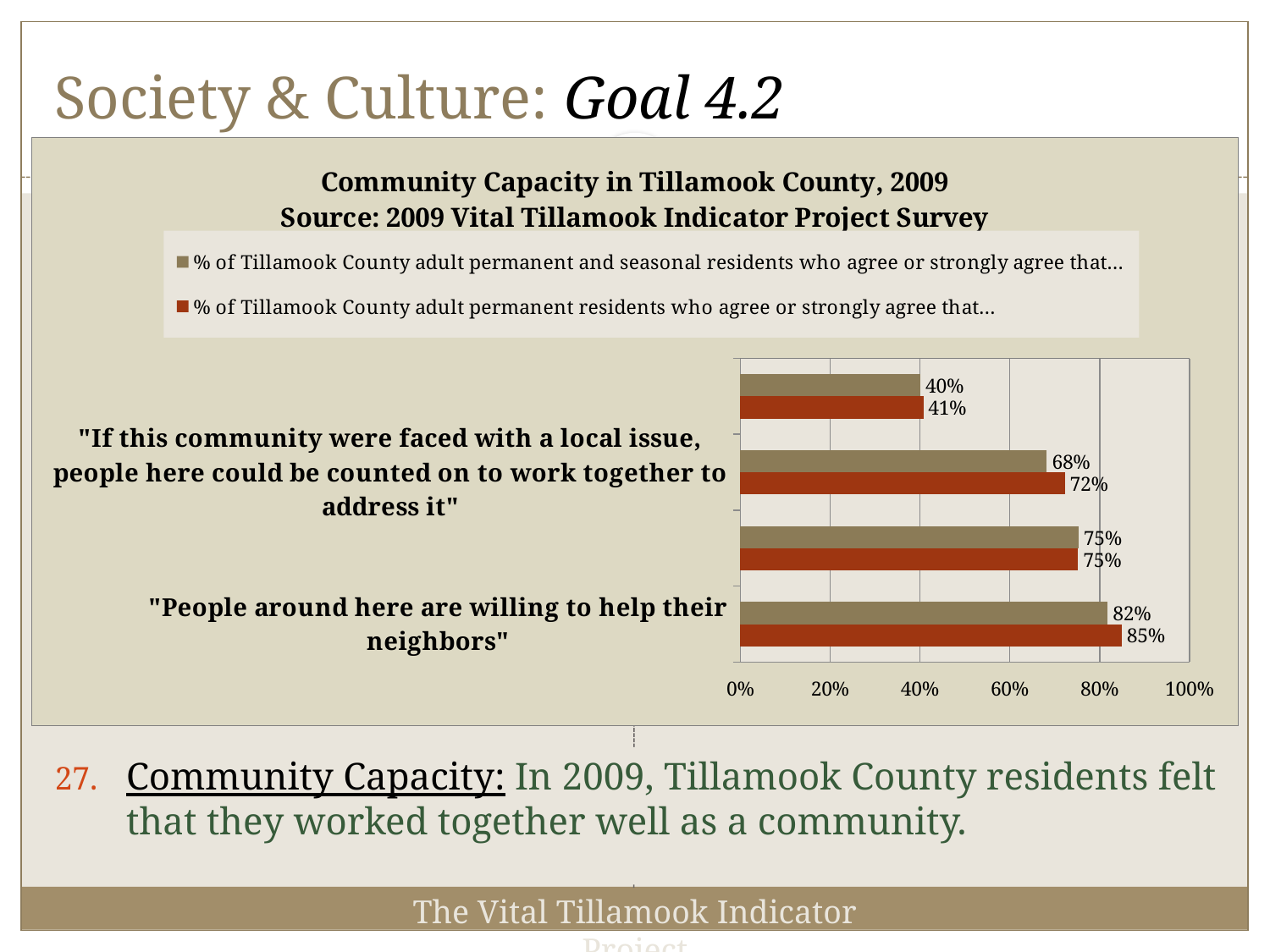
For "People around here are willing to help their neighbors", what is the difference between the permanent residents value and the permanent and seasonal residents value? 3 percentage points What is the title of the chart? Community Capacity in Tillamook County, 2009 Source: 2009 Vital Tillamook Indicator Project Survey What percentage of adult permanent and seasonal residents agree or strongly agree that "If this community were faced with a local issue, people here could be counted on to work together to address it"? 68% For "If this community were faced with a local issue, people here could be counted on to work together to address it", what is the difference between the permanent residents value and the permanent and seasonal residents value? 4 percentage points How many series does the legend list? 2 What is the highest value shown in the chart? 85% What kind of chart is shown on the slide? Bar chart What percentage of Tillamook County adult permanent residents agree or strongly agree that "People around here are willing to help their neighbors"? 85% What is the lowest value shown in the chart? 40% What percentage of Tillamook County adult permanent and seasonal residents agree or strongly agree that "People around here are willing to help their neighbors"? 82% What percentage of adult permanent residents agree or strongly agree that "If this community were faced with a local issue, people here could be counted on to work together to address it"? 72% For "People around here are willing to help their neighbors", which series has the larger value: permanent residents or permanent and seasonal residents? Permanent residents